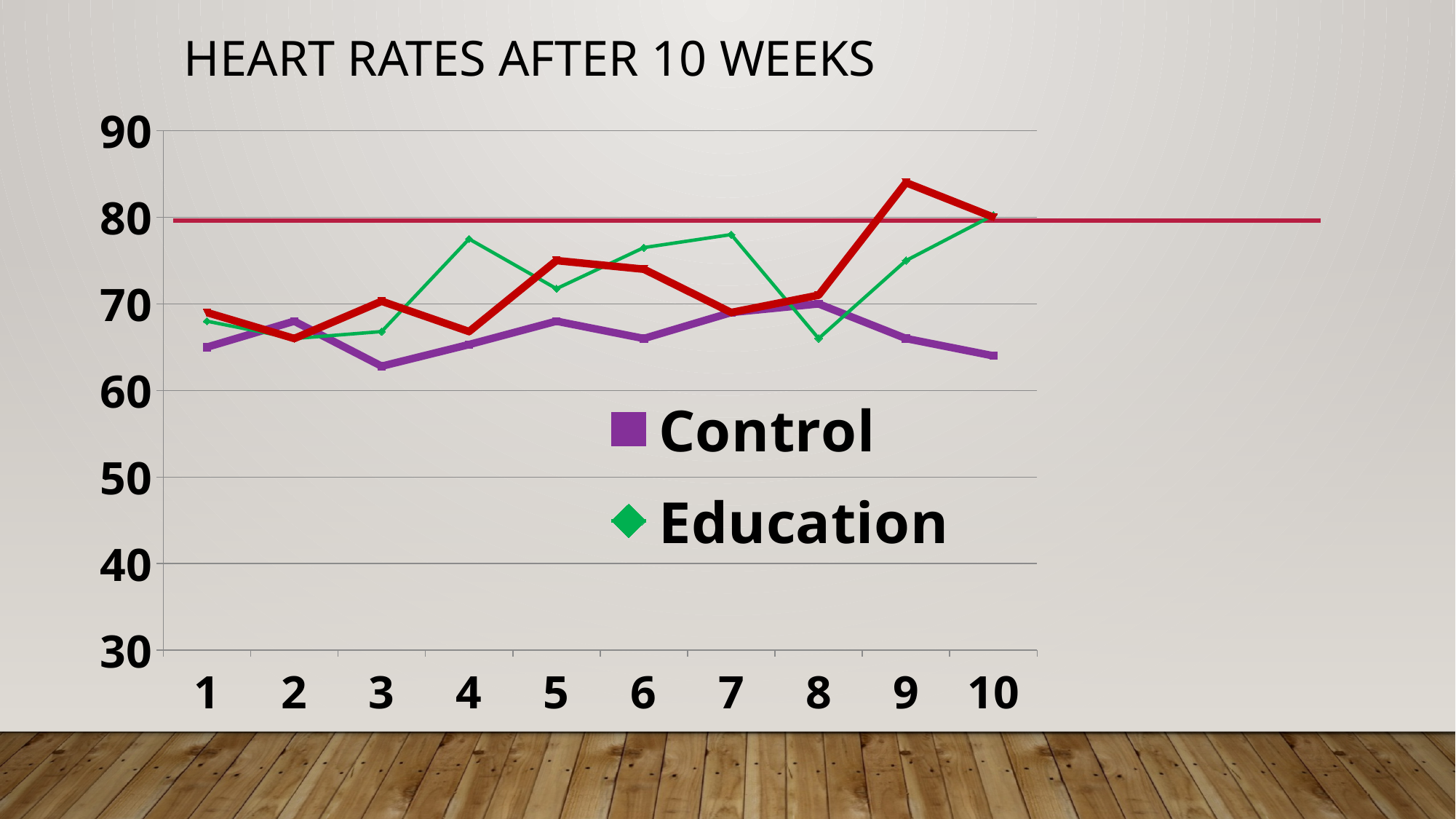
At point 7, which series has the higher value, Control or Education? Education How many points are plotted along the x axis for each series? 10 At point 8, which series has the higher value, Control or Education? Control Is the Education value at point 7 greater or less than 70? greater Which colour is used for the Control series in the legend? purple Is the Control value at point 3 greater or less than 70? less How many series does the legend list? 2 Is the Education value at point 4 greater or less than 70? greater What kind of chart is shown on the slide? line chart What is the title of the chart? HEART RATES AFTER 10 WEEKS Does the Control line rise or fall from point 8 to point 10? fall